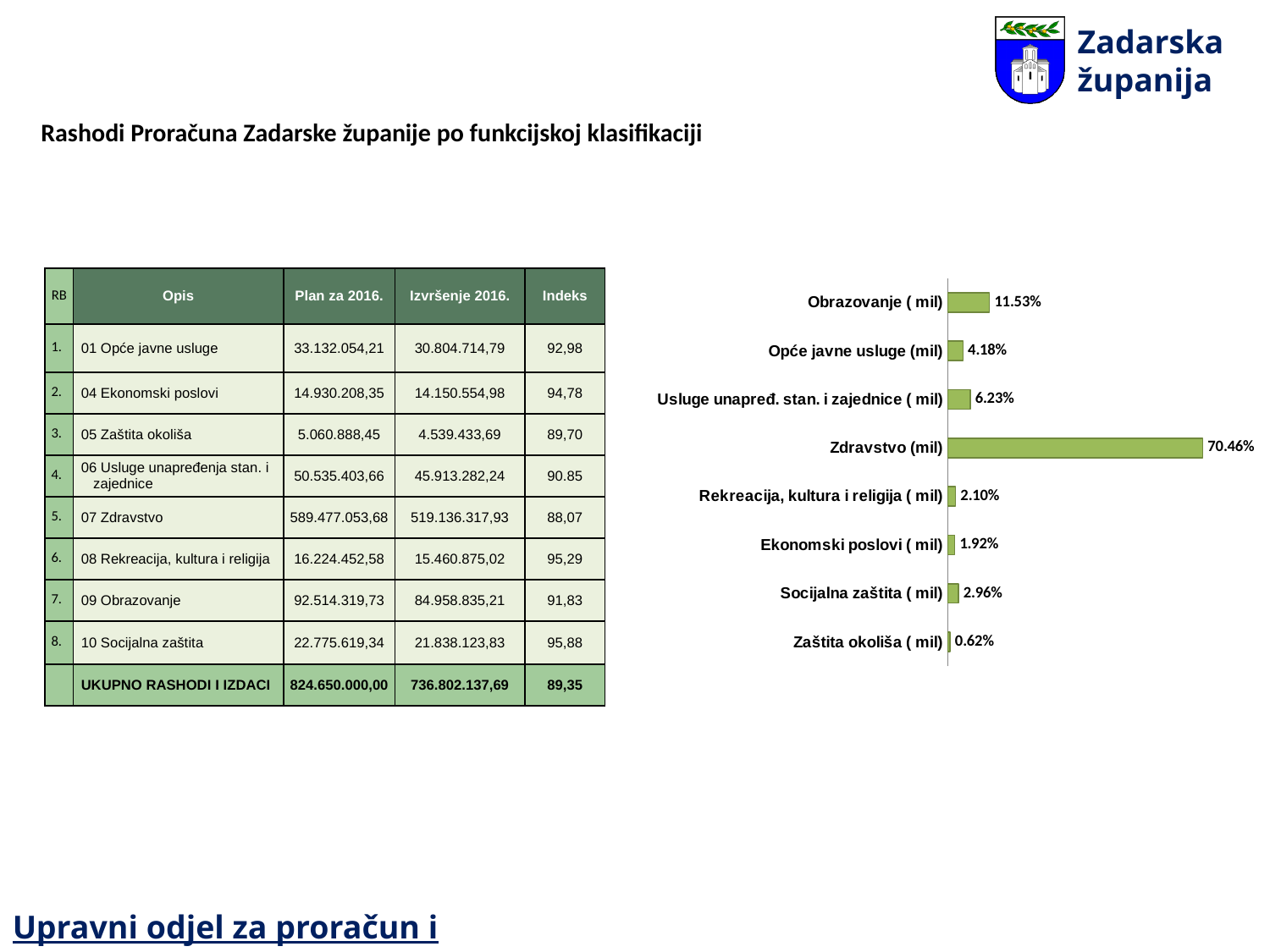
In the bar chart, what is the value for Usluge unapređ. stan. i zajednice ( mil)? 6.23% What kind of chart is shown on the right side of the slide? bar chart In the bar chart, which category has the lowest value? Zaštita okoliša ( mil) In the bar chart, which is larger: the value for Rekreacija, kultura i religija ( mil) or the value for Ekonomski poslovi ( mil)? Rekreacija, kultura i religija ( mil) In the bar chart, what is the difference between the values for Obrazovanje ( mil) and Opće javne usluge (mil)? 7.35% In the bar chart, what is the value for Zdravstvo (mil)? 70.46% In the bar chart, what is the value for Socijalna zaštita ( mil)? 2.96% In the bar chart, what is the difference between the values for Zdravstvo (mil) and Obrazovanje ( mil)? 58.93% In the bar chart, what is the value for Obrazovanje ( mil)? 11.53% How many categories are shown in the bar chart? 8 In the bar chart, which category has the highest value? Zdravstvo (mil) What colour are the bars in the bar chart? green